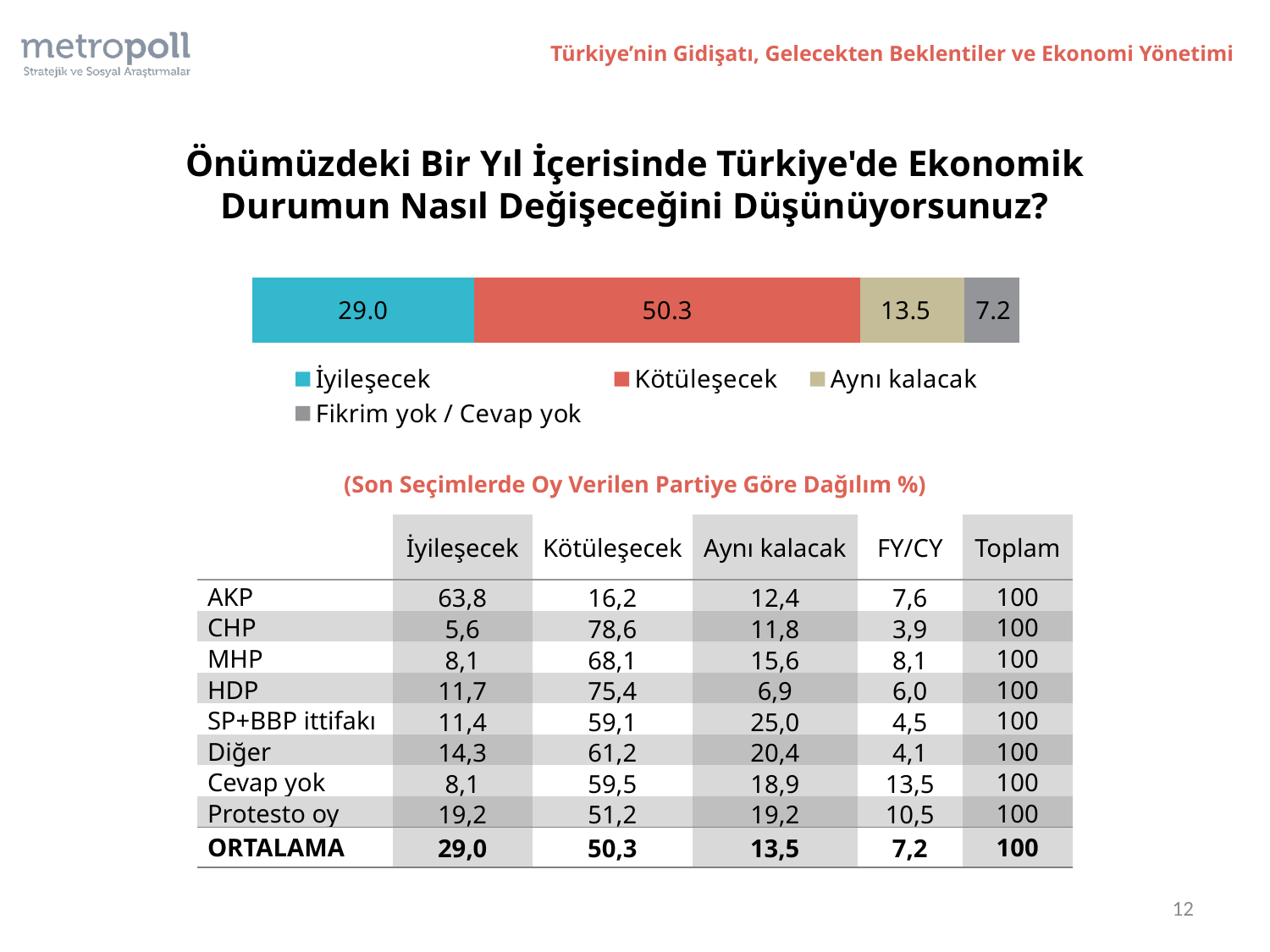
What value is shown for the İyileşecek segment of the stacked bar? 29.0 What type of chart is shown on the slide? Stacked bar chart What is the total of all segments in the stacked bar? 100.0 What value is shown for the Fikrim yok / Cevap yok segment of the stacked bar? 7.2 What is the difference between the Kötüleşecek and İyileşecek values in the stacked bar? 21.3 What value is shown for the Kötüleşecek segment of the stacked bar? 50.3 Which segment of the stacked bar has the largest value? Kötüleşecek What value is shown for the Aynı kalacak segment of the stacked bar? 13.5 Which is larger in the stacked bar, İyileşecek or Aynı kalacak? İyileşecek How many series does the chart legend list? 4 Which segment of the stacked bar has the smallest value? Fikrim yok / Cevap yok What colour is the Kötüleşecek segment in the stacked bar? Red